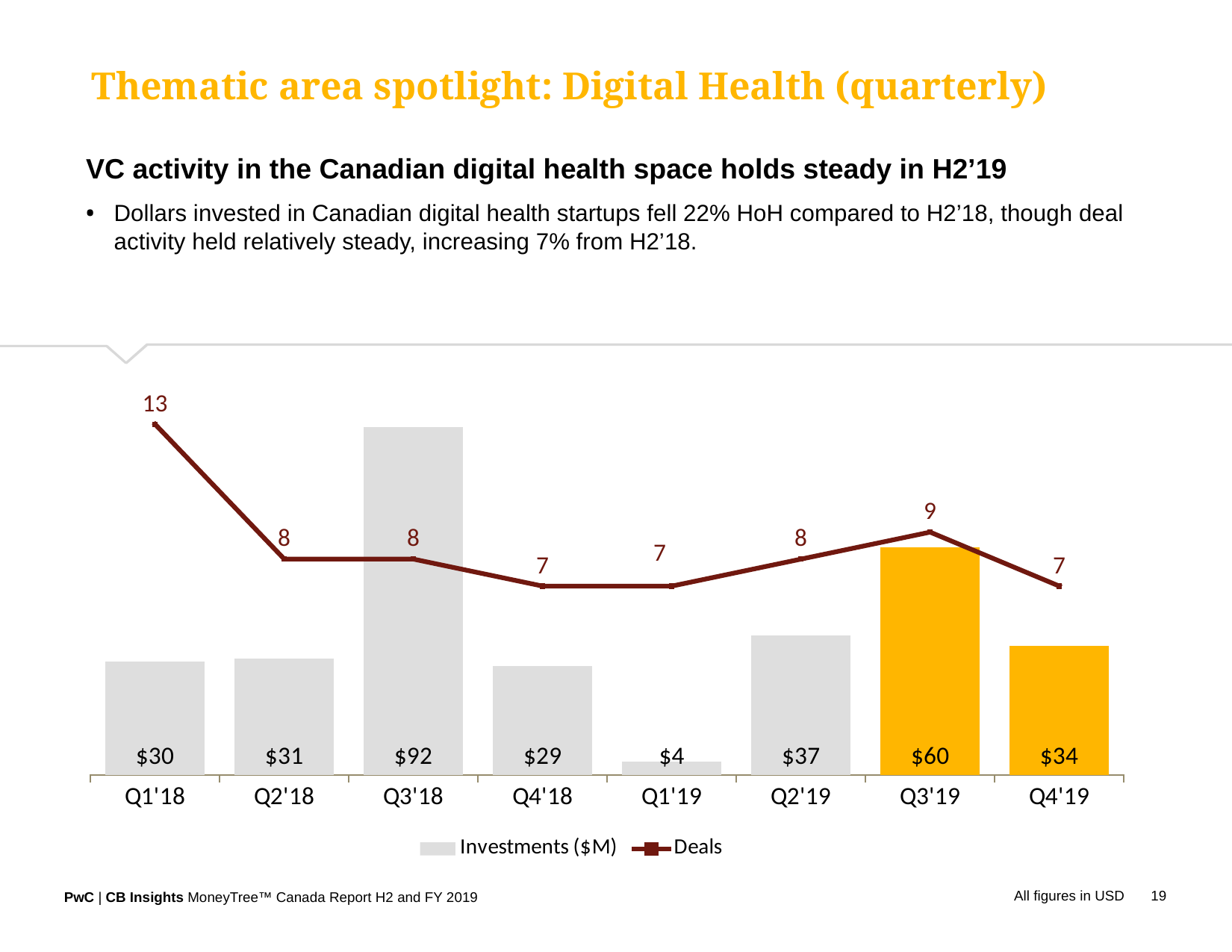
How many quarters are shown on the x axis? 8 How many series does the legend list? 2 What is the Investments ($M) value for Q1'19? $4 Which quarter has the highest number of deals? Q1'18 How many deals were recorded in Q1'18? 13 Which quarter has the lowest Investments ($M) value? Q1'19 What is the difference in Investments ($M) between Q3'19 and Q4'19? $26 Which quarter has a larger Investments ($M) value, Q2'19 or Q4'18? Q2'19 Which quarter has the highest Investments ($M) value? Q3'18 What kind of chart is used to show the Deals series? Line chart What is the Investments ($M) value for Q3'18? $92 Do the number of deals rise or fall from Q1'18 to Q2'18? Fall